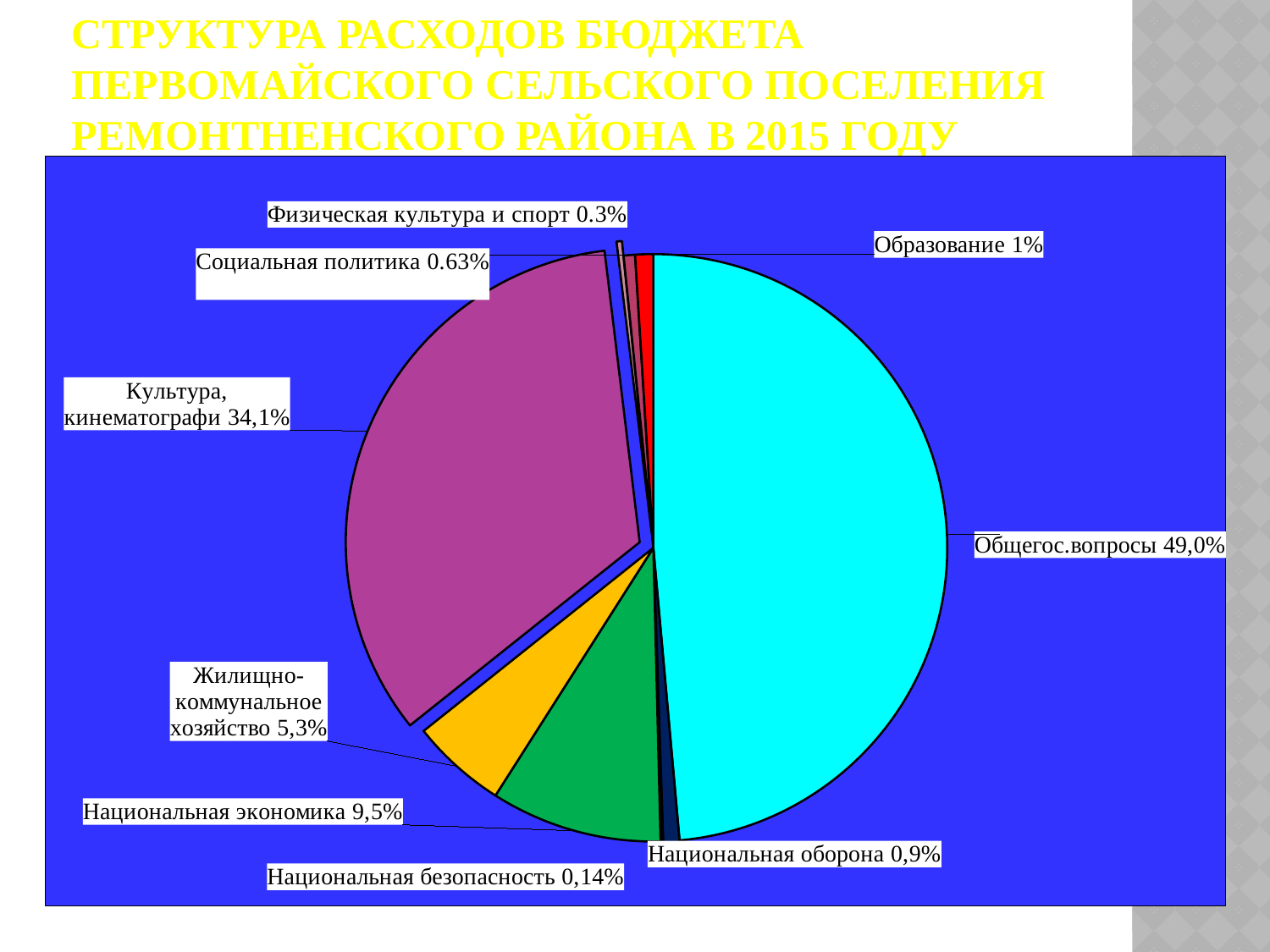
What colour is the slice for Общегос.вопросы? cyan (light blue) Which is larger: the share for Национальная экономика or for Жилищно-коммунальное хозяйство? Национальная экономика Which category has the largest slice of the pie? Общегос.вопросы What share is labelled for Культура, кинематографи? 34,1% What share is labelled for Национальная экономика? 9,5% What share is labelled for Национальная оборона? 0,9% What kind of chart is shown on the slide? pie chart What share of budget expenditure is labelled for Общегос.вопросы? 49,0% How many categories (slices) does the pie chart show? 9 What is the difference between the shares of Общегос.вопросы and Культура, кинематографи? 14,9% Which category has the smallest labelled share? Национальная безопасность What share is labelled for Жилищно-коммунальное хозяйство? 5,3%